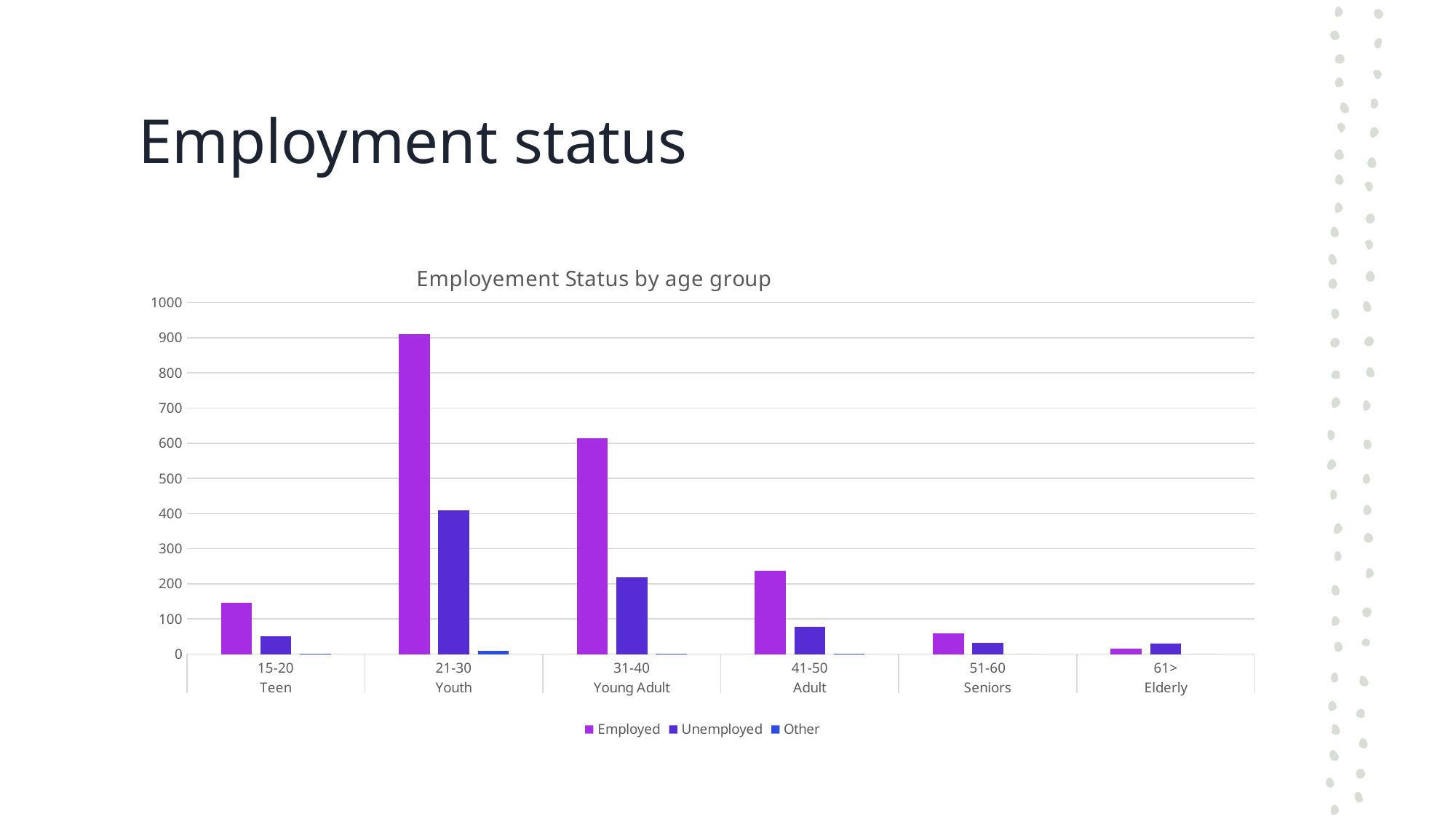
Is the Employed value for 15-20 Teen greater or less than 200? less What is the title of the chart? Employement Status by age group Is the Employed value for 31-40 Young Adult greater or less than 500? greater Which age group has the highest Employed value? 21-30 Youth What kind of chart is shown on the slide? Bar chart Which age group has the lowest Employed value? 61> Elderly How many age groups are shown on the x axis? 6 Which age group has the highest Unemployed value? 21-30 Youth Is the Unemployed value for 21-30 Youth greater or less than 300? greater How many series does the legend list? 3 For the 41-50 Adult group, which is larger: Employed or Unemployed? Employed